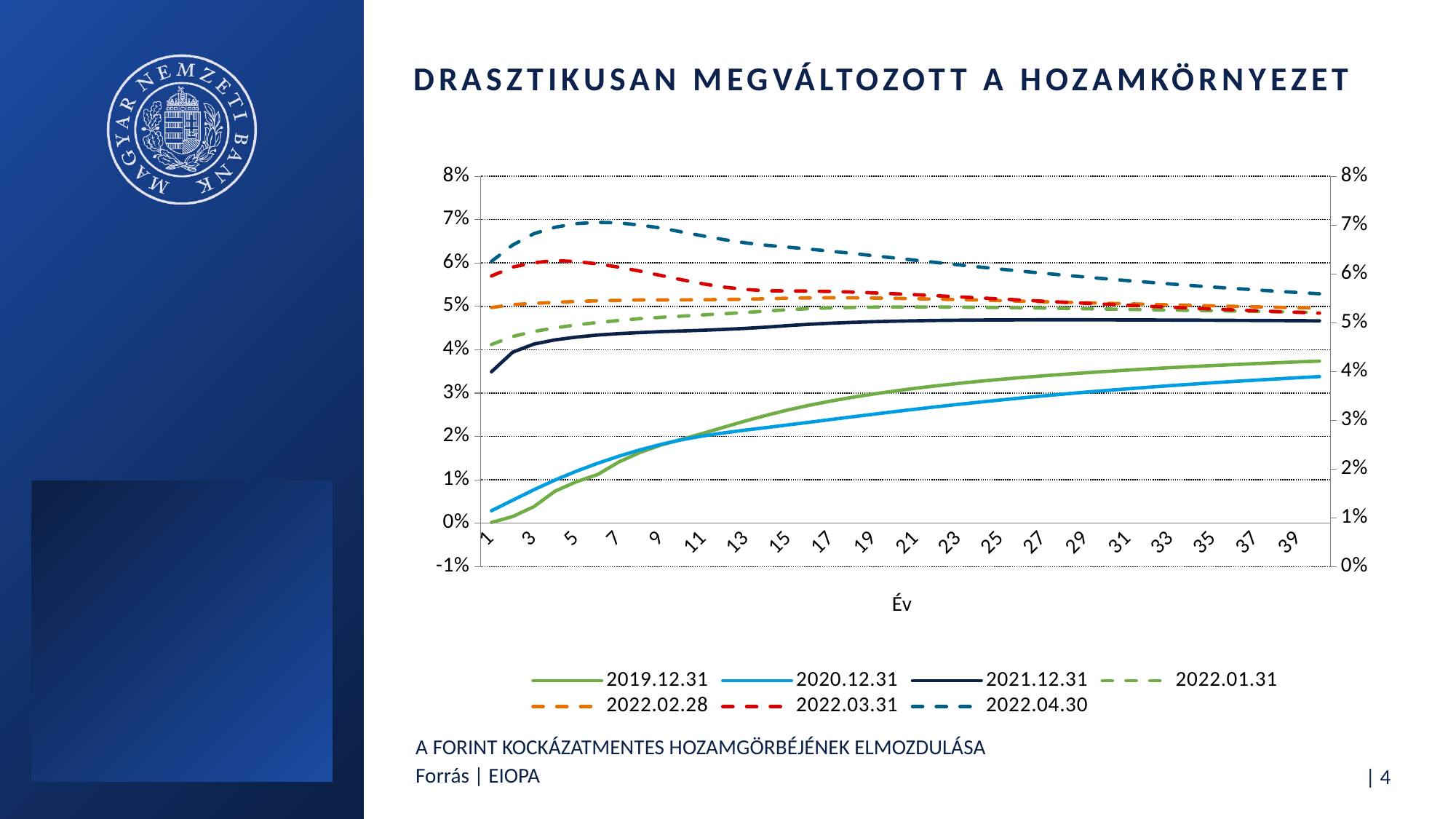
What kind of chart is shown on the slide? line chart Is the value of the 2022.03.31 series at year 5 greater or less than 5%? greater Does the 2022.04.30 series rise or fall from year 7 to year 39? falls At year 1, which series is larger: 2022.04.30 or 2021.12.31? 2022.04.30 Which series has the lowest value at year 1? 2019.12.31 Is the value of the 2022.04.30 series at year 7 greater or less than 6%? greater At year 39, which series is larger: 2019.12.31 or 2020.12.31? 2019.12.31 Is the value of the 2019.12.31 series at year 39 greater or less than 5%? less How many series does the chart legend list? 7 Does the 2019.12.31 series rise or fall as the year increases? rises Which series has the highest value at year 7? 2022.04.30 What is the label of the chart's x axis? Év